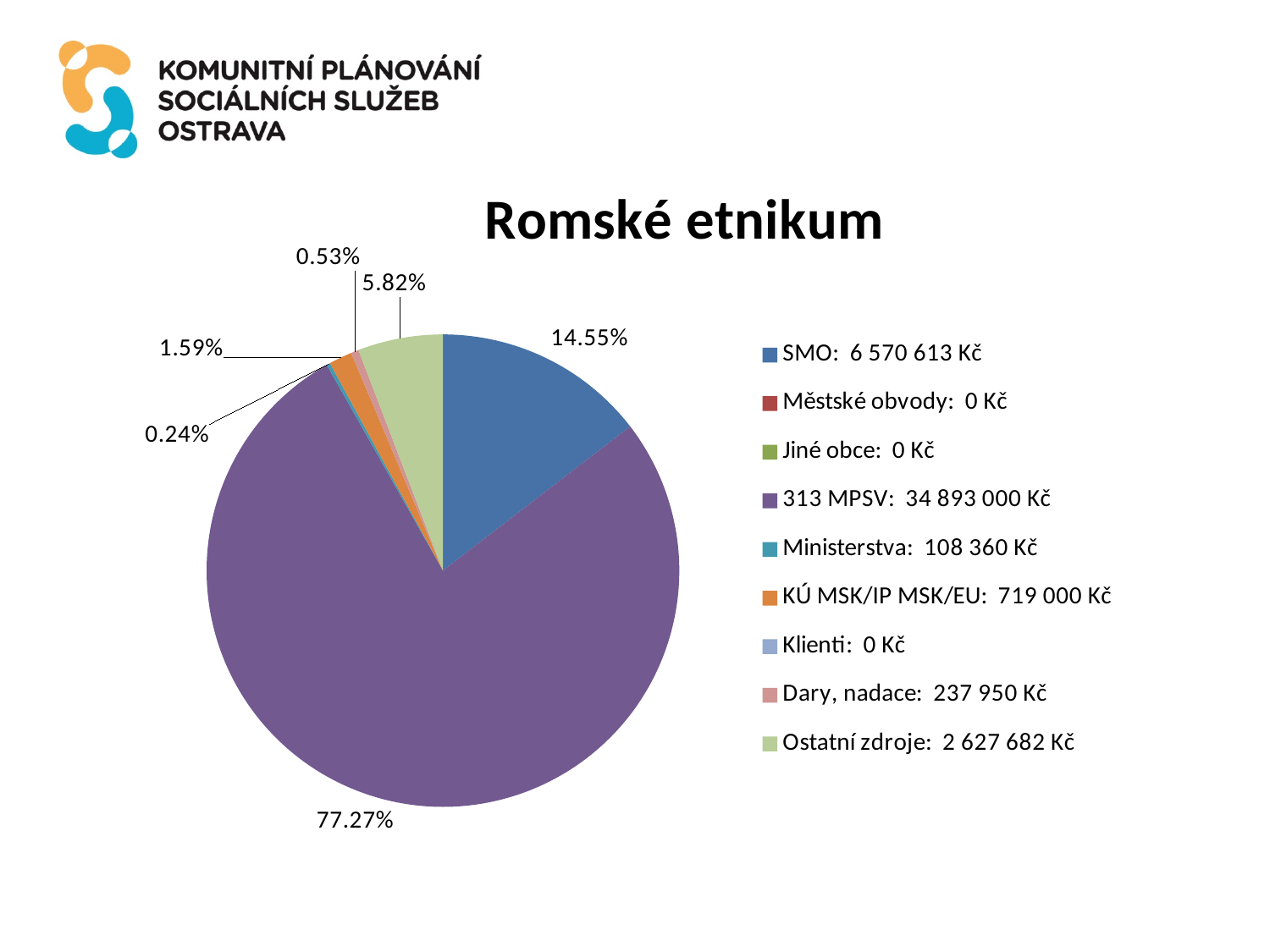
What share of the pie does SMO represent? 14.55% What is the title of the chart? Romské etnikum What kind of chart is shown on the slide? pie chart What is the value for Ostatní zdroje? 2 627 682 Kč What is the value for Dary, nadace? 237 950 Kč What is the difference between the value for 313 MPSV and the value for SMO? 28 322 387 Kč What is the value for 313 MPSV? 34 893 000 Kč What is the value for SMO? 6 570 613 Kč Which category has the largest share of the pie? 313 MPSV How many categories does the legend list? 9 What share of the pie does 313 MPSV represent? 77.27% Which is larger, the value for SMO or the value for Ostatní zdroje? SMO